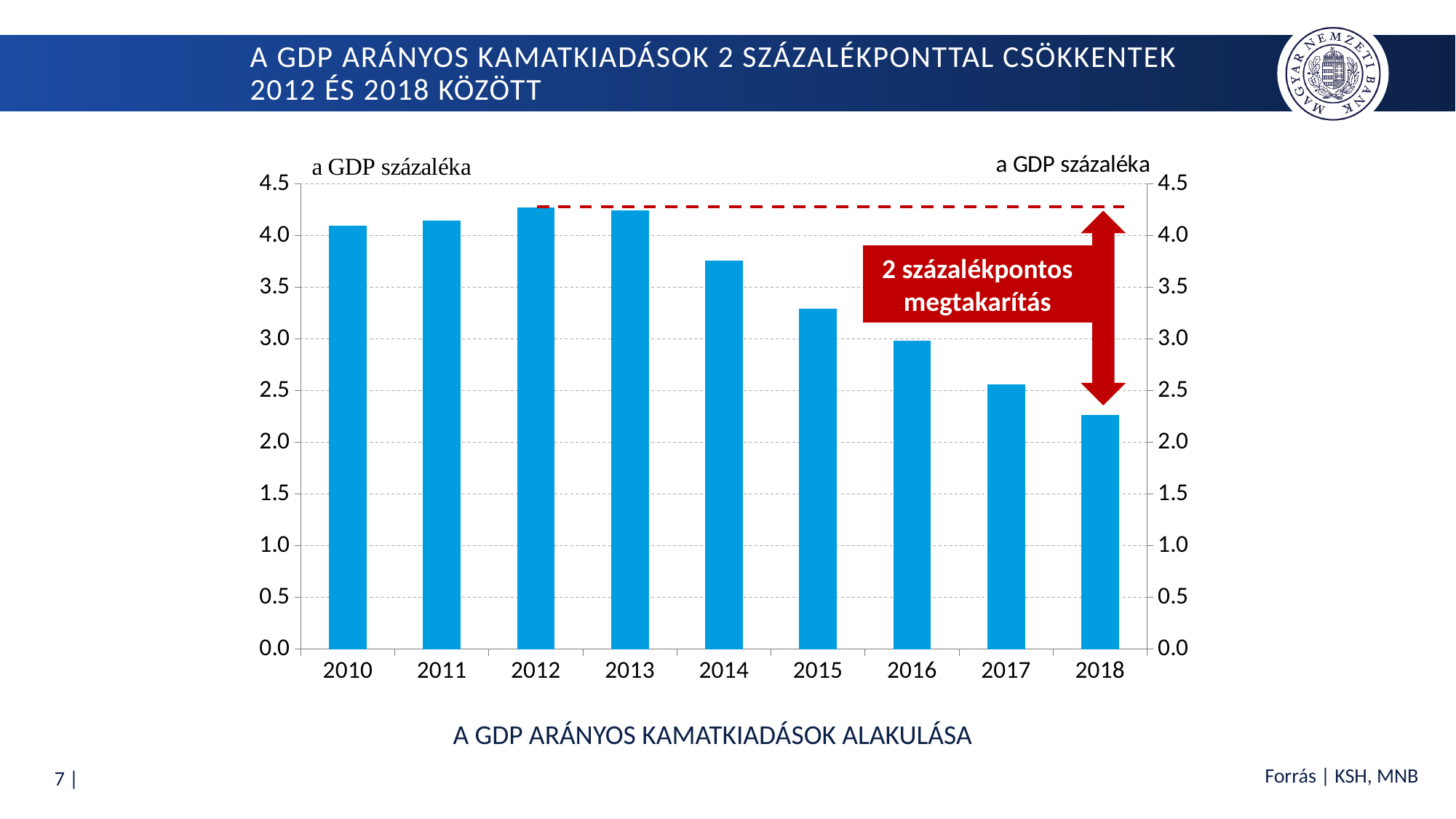
What kind of chart is shown on the slide? bar chart How many years are shown on the x axis of the chart? 9 Is the value for 2018 greater or less than 2.0? greater What unit label is shown above the vertical axis of the chart? a GDP százaléka Which is larger, the value for 2014 or the value for 2015? 2014 Is the value for 2017 greater or less than 3.0? less Do the values rise or fall from 2013 to 2018? fall What is the title of the chart shown below the plot? A GDP ARÁNYOS KAMATKIADÁSOK ALAKULÁSA Is the value for 2015 greater or less than 3.5? less Which year has the lowest value in the chart? 2018